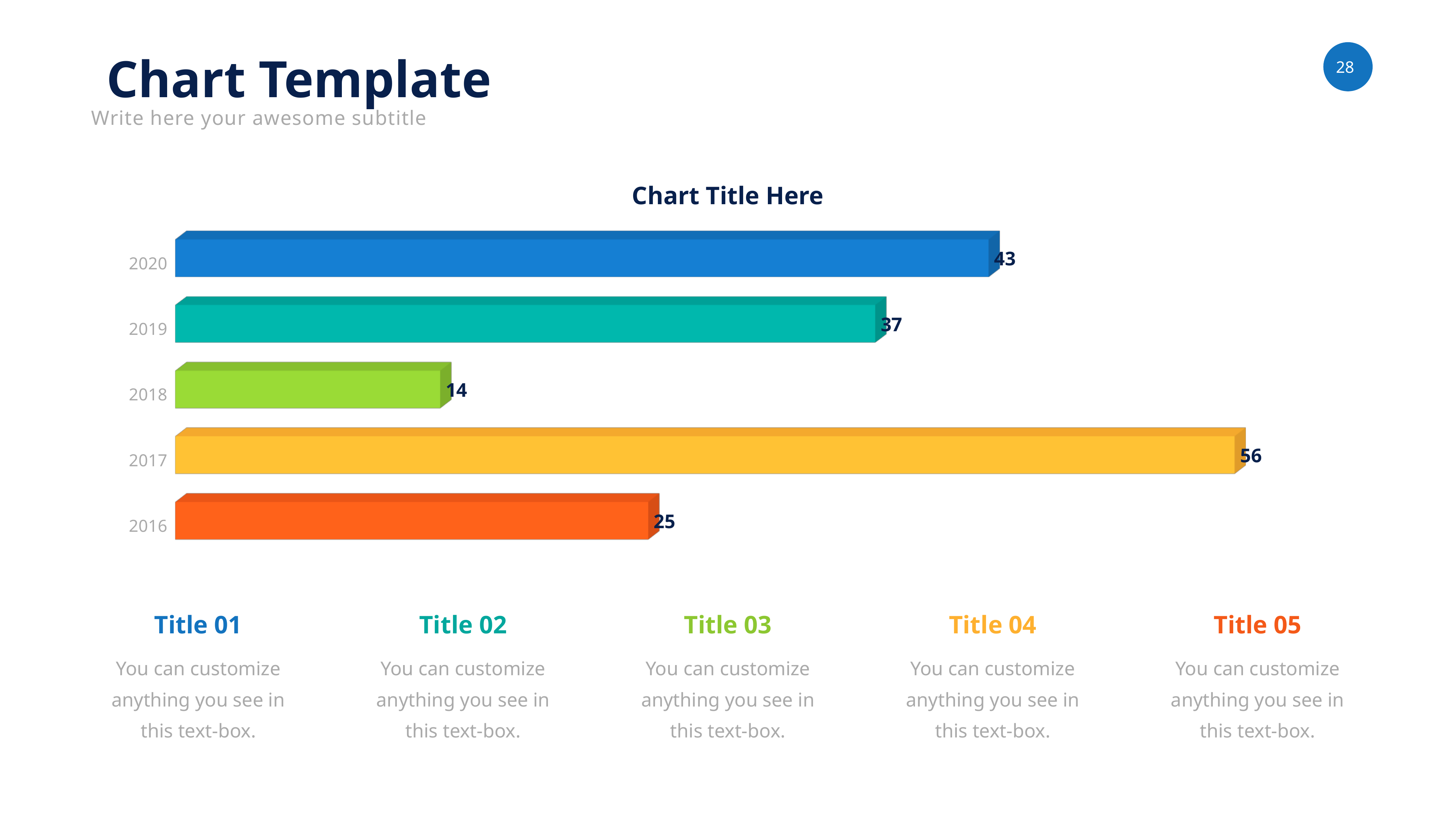
What is the value for 2016? 25 What is the difference between the values for 2017 and 2018? 42 What is the difference between the values for 2020 and 2019? 6 What is the value for 2018? 14 Which year has the lowest value? 2018 Which year has the highest value? 2017 How many years are shown in the chart? 5 What kind of chart is shown on the slide? bar chart What colour is the bar for 2017? yellow What is the value for 2020? 43 Which is larger, the value for 2019 or the value for 2016? 2019 What is the title of the chart? Chart Title Here